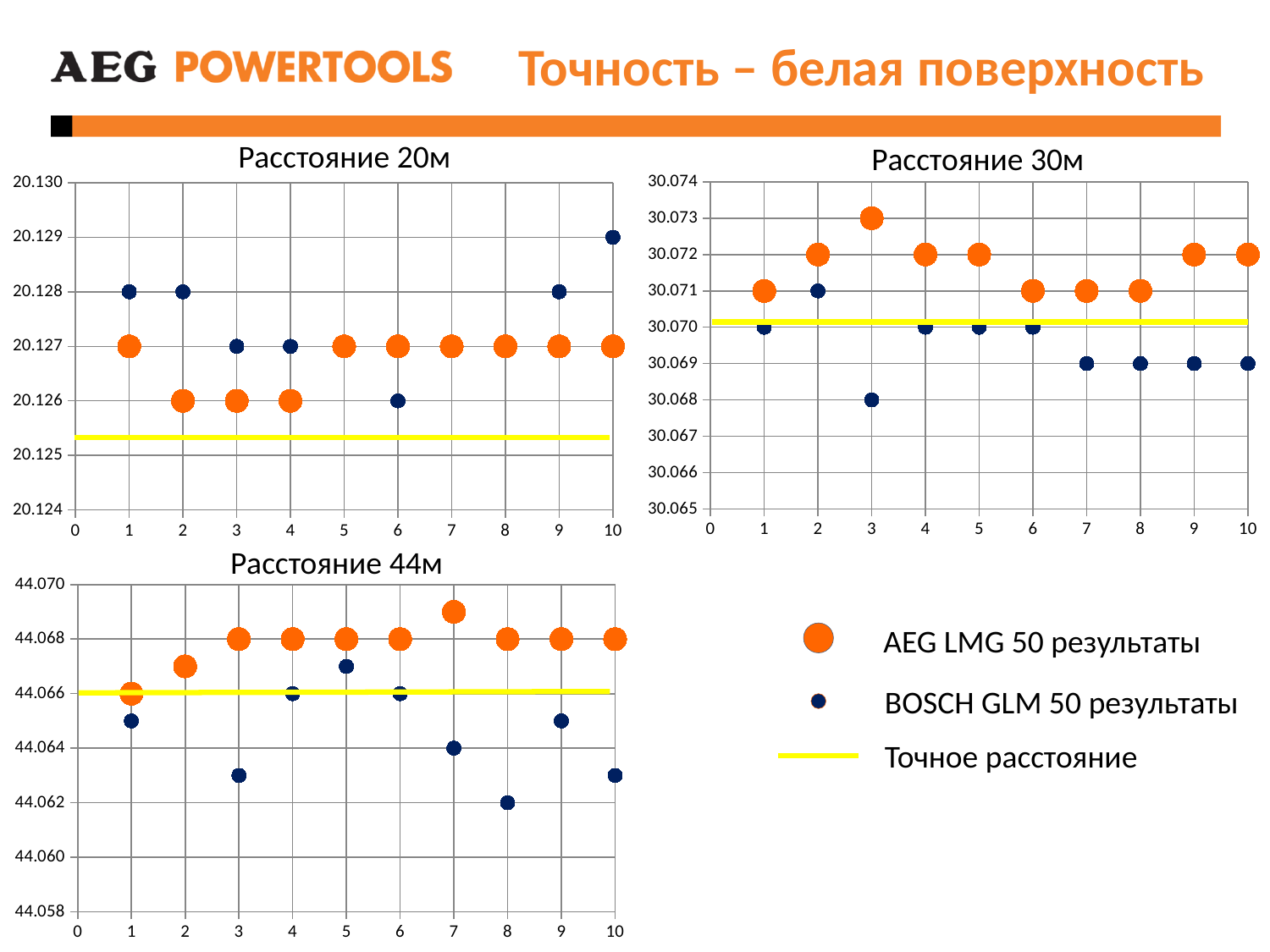
How many measurement points does each series have in the "Расстояние 30м" chart? 10 In the "Расстояние 30м" chart, what is the AEG LMG 50 value at measurement 3? 30.073 In the "Расстояние 20м" chart, which series has the higher value at measurement 1, AEG LMG 50 or BOSCH GLM 50? BOSCH GLM 50 In the "Расстояние 20м" chart, what is the BOSCH GLM 50 value at measurement 10? 20.129 How many entries does the legend on the slide list? 3 In the "Расстояние 30м" chart, what is the difference between the AEG LMG 50 and BOSCH GLM 50 values at measurement 3? 0.005 What kind of chart is the "Расстояние 20м" chart? scatter chart In the "Расстояние 20м" chart, what is the AEG LMG 50 value at measurement 2? 20.126 In the "Расстояние 44м" chart, what is the BOSCH GLM 50 value at measurement 8? 44.062 In the "Расстояние 30м" chart, at which measurement number is the AEG LMG 50 result highest? 3 In the "Расстояние 44м" chart, is the AEG LMG 50 value at measurement 7 greater or less than 44.068? greater In the "Расстояние 30м" chart, at which measurement number is the BOSCH GLM 50 result lowest? 3